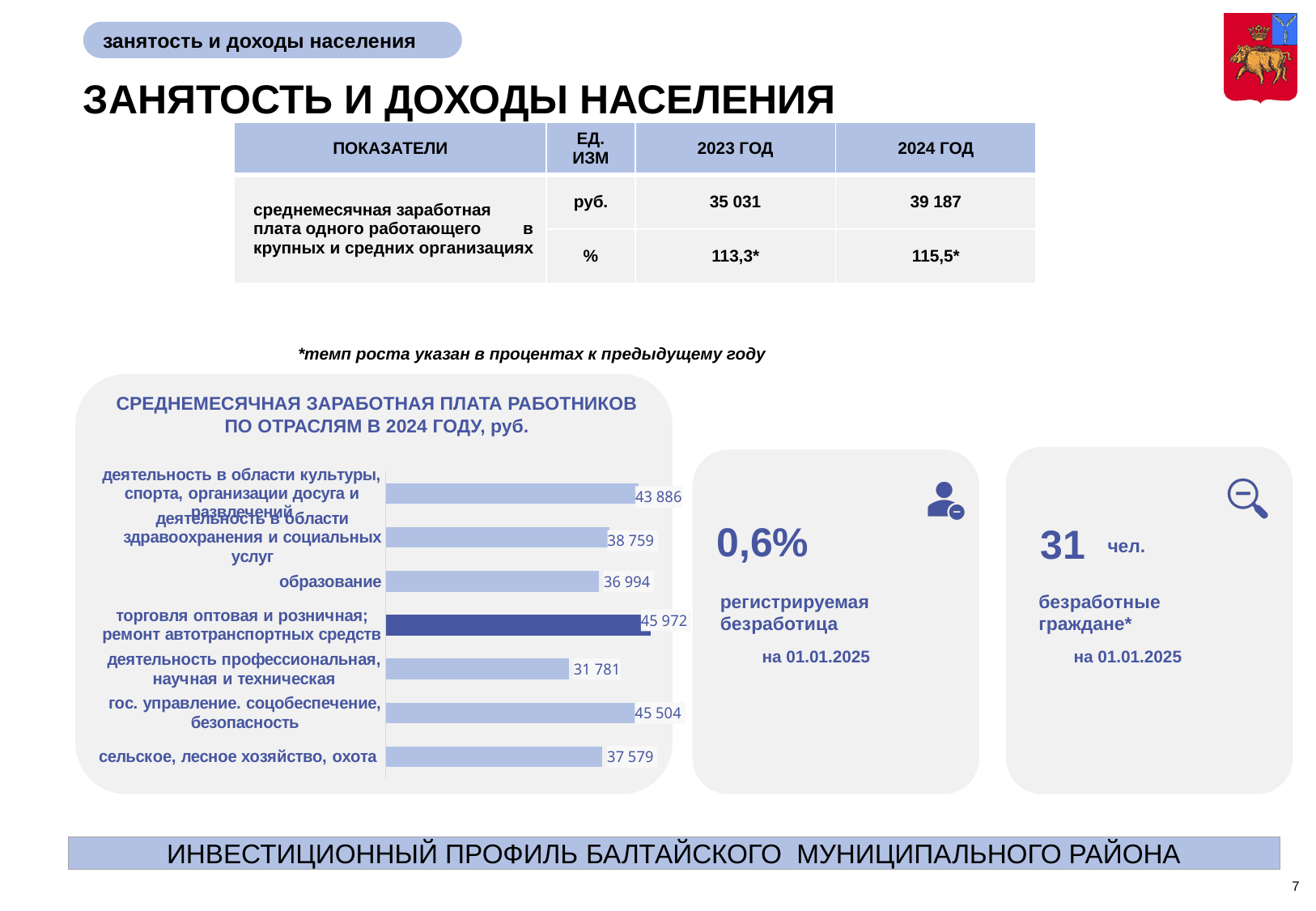
What is the difference between the salary for деятельность в области культуры, спорта, организации досуга и развлечений and деятельность в области здравоохранения и социальных услуг? 5 127 Which sector has the highest average monthly salary in the chart? торговля оптовая и розничная; ремонт автотранспортных средств What is the difference between the salary for торговля оптовая и розничная; ремонт автотранспортных средств and гос. управление. соцобеспечение, безопасность? 468 Which sector's bar is drawn in a darker blue than the others? торговля оптовая и розничная; ремонт автотранспортных средств What is the value for сельское, лесное хозяйство, охота? 37 579 What value is shown for торговля оптовая и розничная; ремонт автотранспортных средств? 45 972 What is the average monthly salary for образование in the chart? 36 994 What is the value for деятельность в области здравоохранения и социальных услуг? 38 759 Which is larger: the salary for образование or for сельское, лесное хозяйство, охота? сельское, лесное хозяйство, охота How many sectors are shown in the bar chart? 7 What type of chart is used to show average monthly salary by sector? bar chart Which sector has the lowest average monthly salary in the chart? деятельность профессиональная, научная и техническая